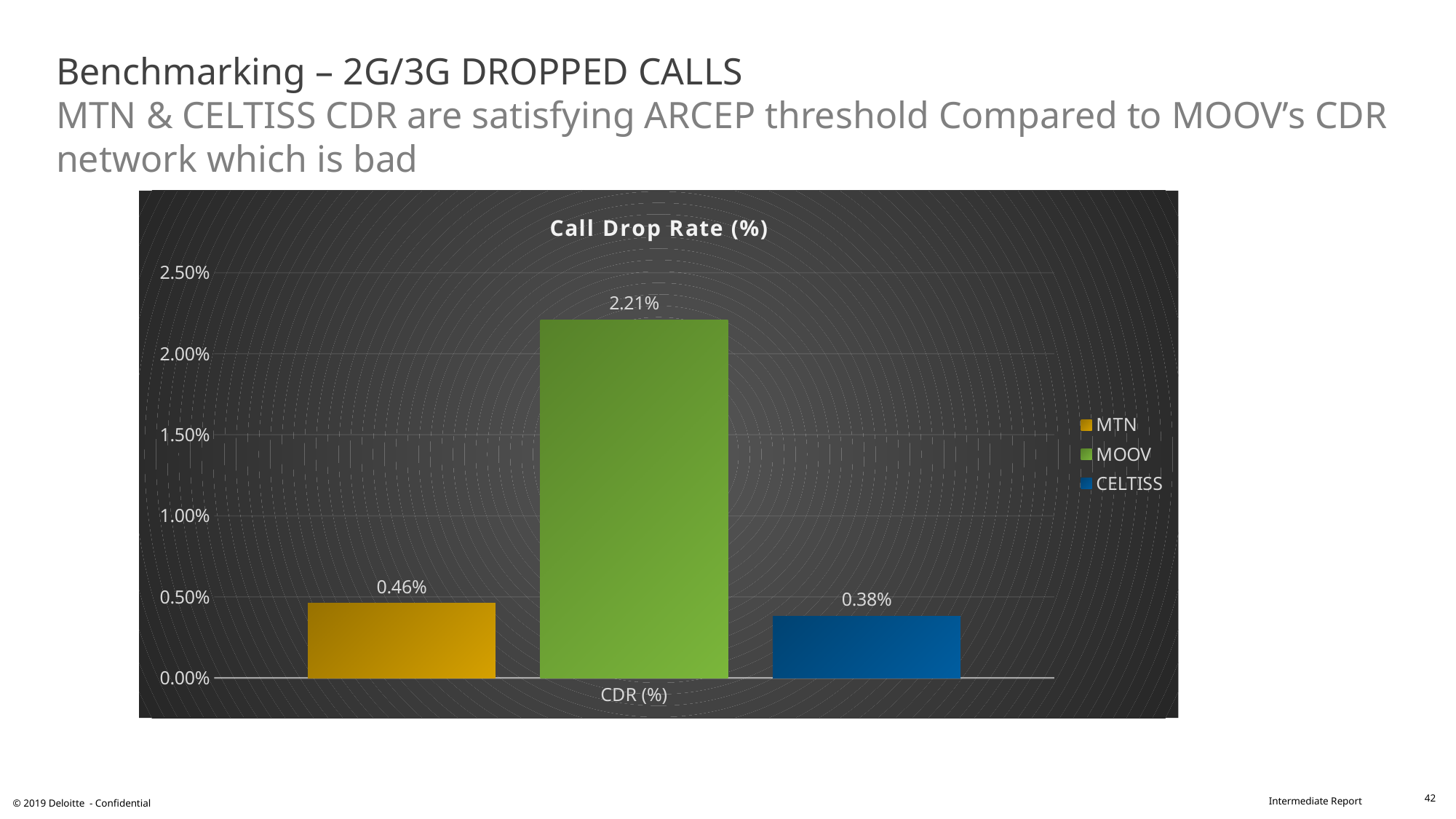
What is the difference between MOOV's and MTN's Call Drop Rate? 1.75% What kind of chart is shown on the slide? Bar chart What is the Call Drop Rate for CELTISS? 0.38% How many series does the legend list? 3 What is the title of the chart? Call Drop Rate (%) Is the Call Drop Rate for MOOV greater or less than 2.00%? greater What is the difference between MTN's and CELTISS's Call Drop Rate? 0.08% What is the Call Drop Rate for MTN? 0.46% Which operator has the highest Call Drop Rate? MOOV Which has a higher Call Drop Rate, MTN or CELTISS? MTN Which operator has the lowest Call Drop Rate? CELTISS What is the Call Drop Rate for MOOV? 2.21%